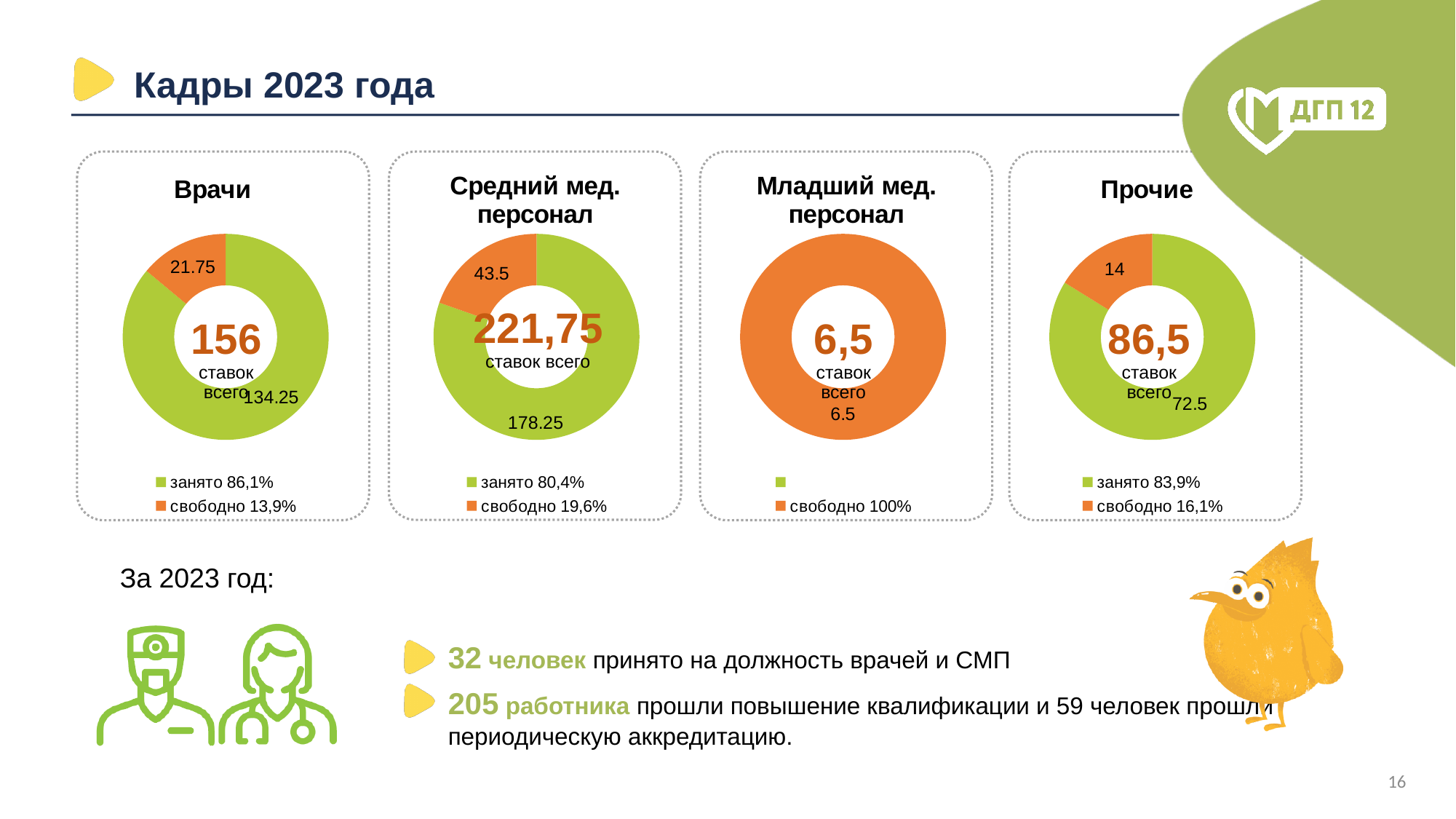
In the "Средний мед. персонал" chart, what is the value of the "свободно" slice? 43.5 In the "Врачи" chart, what is the value of the "занято" (green) slice? 134.25 In the "Прочие" chart, what is the difference between the "занято" and "свободно" values? 58.5 What kind of chart is used in the "Средний мед. персонал" panel? Donut (pie) chart In the "Средний мед. персонал" chart, what is the value of the "занято" slice? 178.25 In the "Врачи" chart, which slice is larger, "занято" or "свободно"? занято How many donut charts are shown on the slide? 4 In the "Прочие" chart, what share is "занято" according to the legend? 83,9% In the "Врачи" chart, what is the value of the "свободно" (orange) slice? 21.75 In the "Прочие" chart, what is the value of the "свободно" slice? 14 In the "Младший мед. персонал" chart, what share of the positions is "свободно" according to the legend? 100% What total number of positions ("ставок всего") is shown in the centre of the "Средний мед. персонал" chart? 221,75